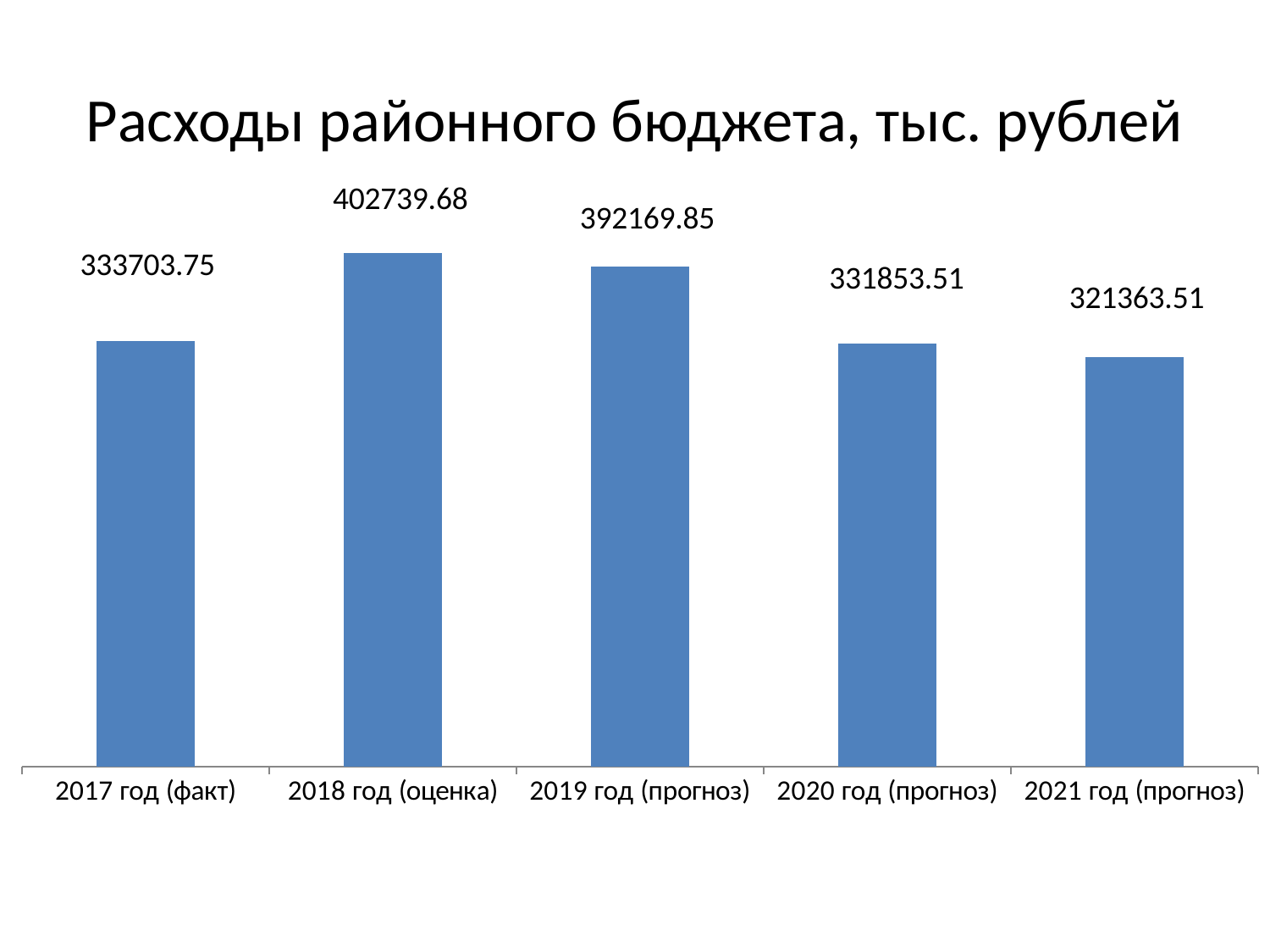
Which is larger, the value for 2019 год (прогноз) or the value for 2020 год (прогноз)? 2019 год (прогноз) What is the difference between the values for 2018 год (оценка) and 2017 год (факт)? 69035.93 What is the difference between the values for 2020 год (прогноз) and 2021 год (прогноз)? 10490.00 Which category has the lowest value? 2021 год (прогноз) What is the value for 2017 год (факт)? 333703.75 What is the value for 2021 год (прогноз)? 321363.51 How many categories are shown on the chart? 5 What is the title of the chart? Расходы районного бюджета, тыс. рублей Which category has the highest value? 2018 год (оценка) What kind of chart is shown on the slide? bar chart What is the value for 2018 год (оценка)? 402739.68 What is the value for 2019 год (прогноз)? 392169.85